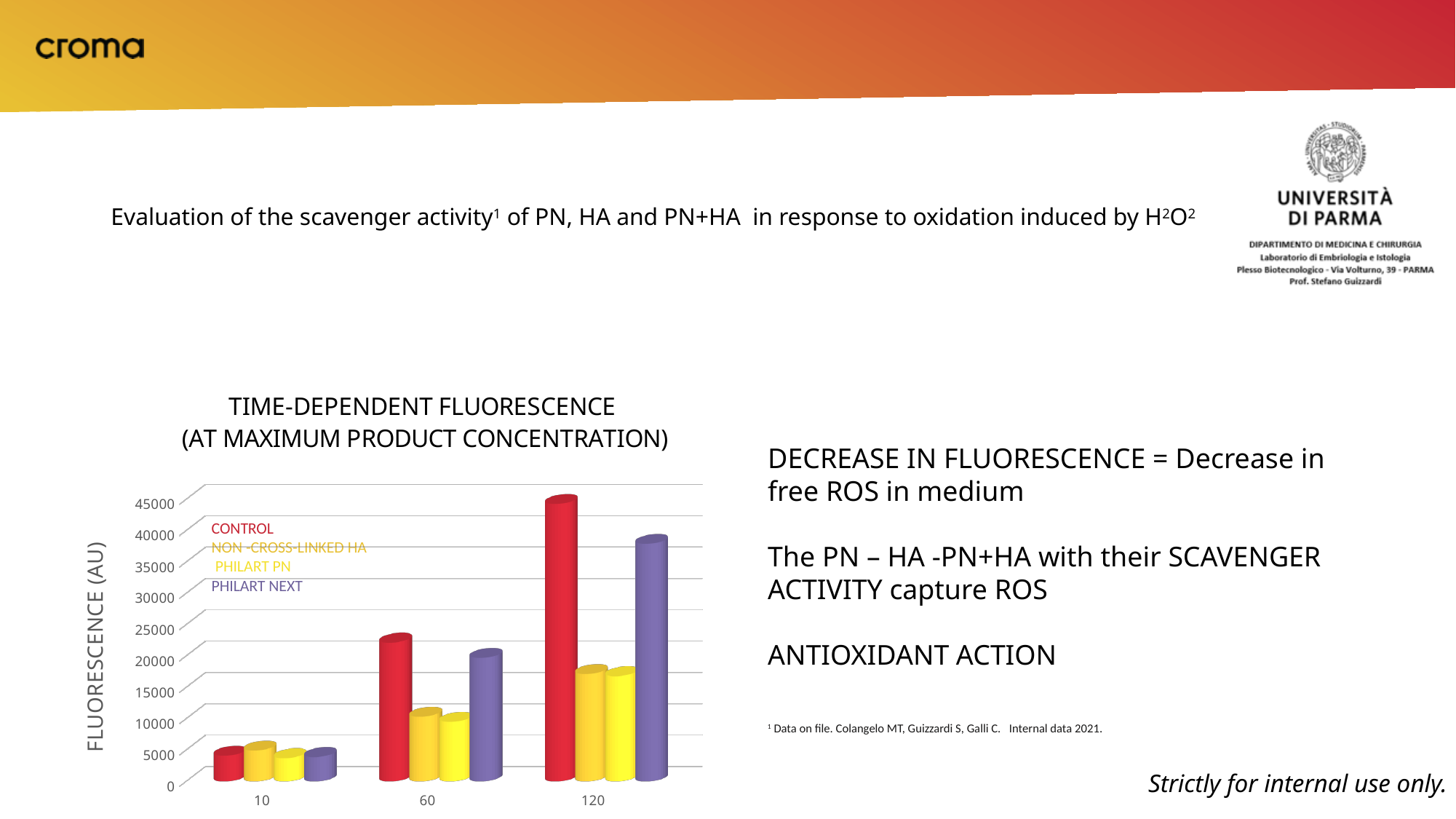
What kind of chart is shown on the slide? bar chart What colour are the PHILART NEXT bars in the chart? purple At time point 60, which is larger: CONTROL or PHILART PN? CONTROL How many series does the chart's legend list? 4 Do the CONTROL values rise or fall from time point 10 to 120? rise Is the PHILART NEXT value at time point 60 greater or less than 15000? greater What is the label of the chart's vertical axis? FLUORESCENCE (AU) At time point 120, which series has the highest fluorescence? CONTROL How many time-point categories are shown on the x axis of the chart? 3 Is the NON-CROSS-LINKED HA value at time point 120 greater or less than 20000? less At time point 120, which is larger: CONTROL or PHILART NEXT? CONTROL Is the CONTROL value at time point 120 greater or less than 40000? greater